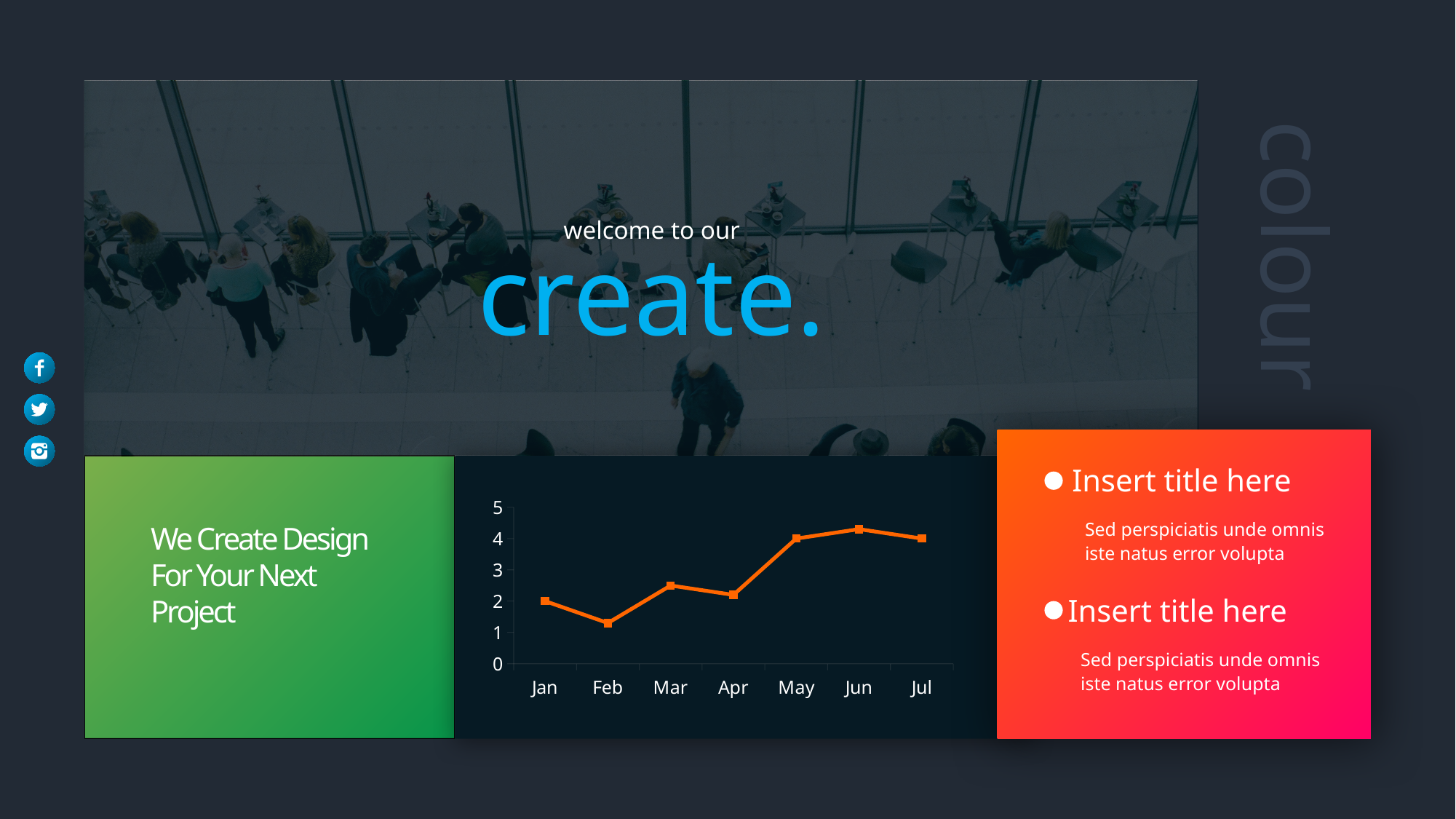
Which month has the highest value in the chart? Jun What colour is the line in the chart? orange How many months are plotted on the x axis of the chart? 7 Which is larger, the value for May or the value for Mar? May Is the value for Jun greater or less than 4? greater What kind of chart is shown on the slide? line chart Is the value for Mar greater or less than 2? greater Which month has the lowest value in the chart? Feb Is the value for Apr greater or less than 3? less Which is larger, the value for Jun or the value for Feb? Jun Does the line rise or fall from Feb to Jun? rise